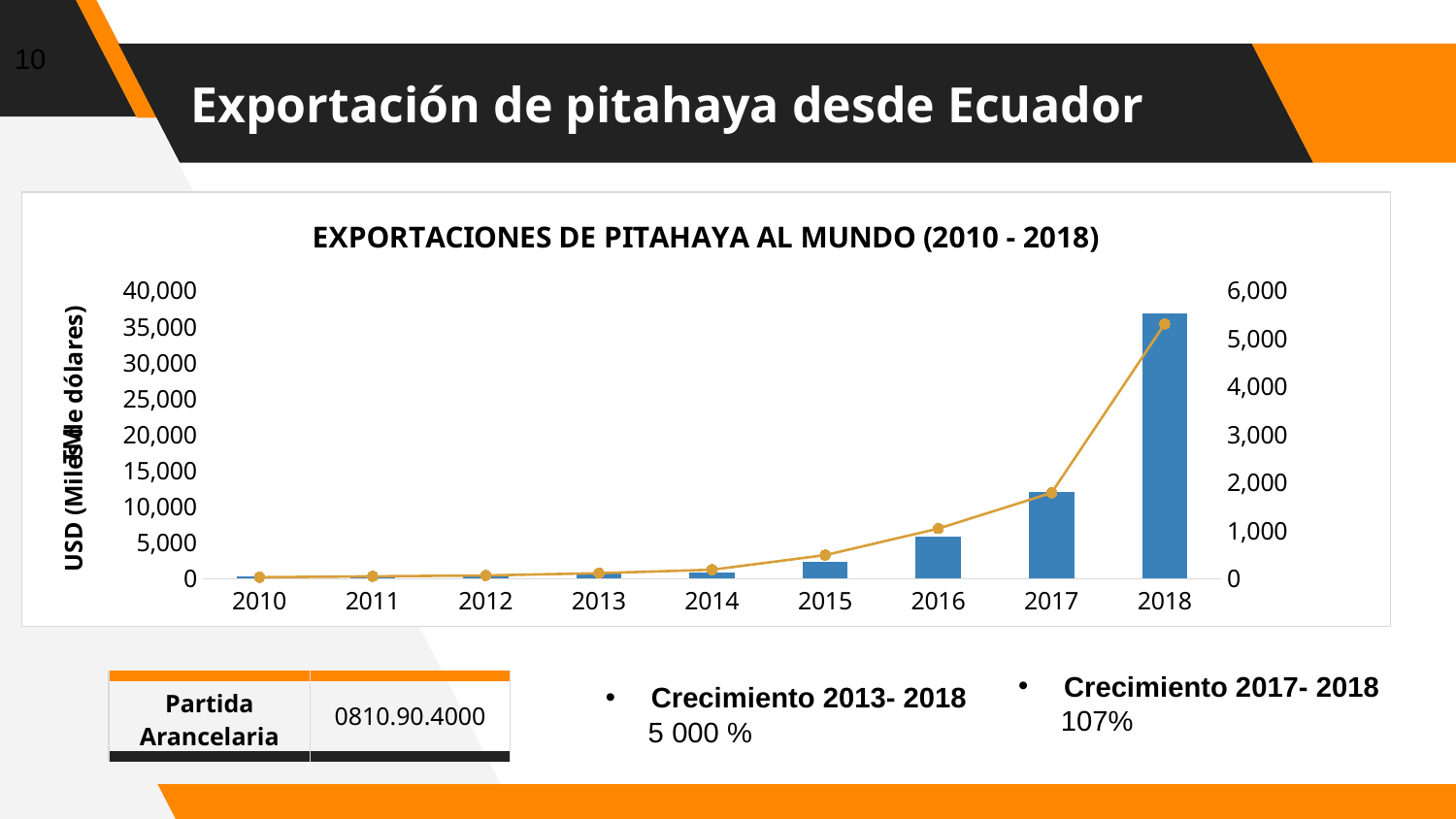
What is the title of the chart? EXPORTACIONES DE PITAHAYA AL MUNDO (2010 - 2018) What is the label of the left vertical axis of the chart? USD (Miles de dólares) Is the line value for 2018 on the right axis greater or less than 4,000? greater What type of chart is shown on the slide? Combined bar and line chart Do the bar values generally rise or fall from 2010 to 2018? Rise Is the bar value for 2017 on the left axis greater or less than 10,000? greater Which year has the tallest bar in the chart? 2018 Which year has the larger bar, 2016 or 2017? 2017 Is the bar value for 2015 on the left axis greater or less than 5,000? less How many years are shown on the x axis of the chart? 9